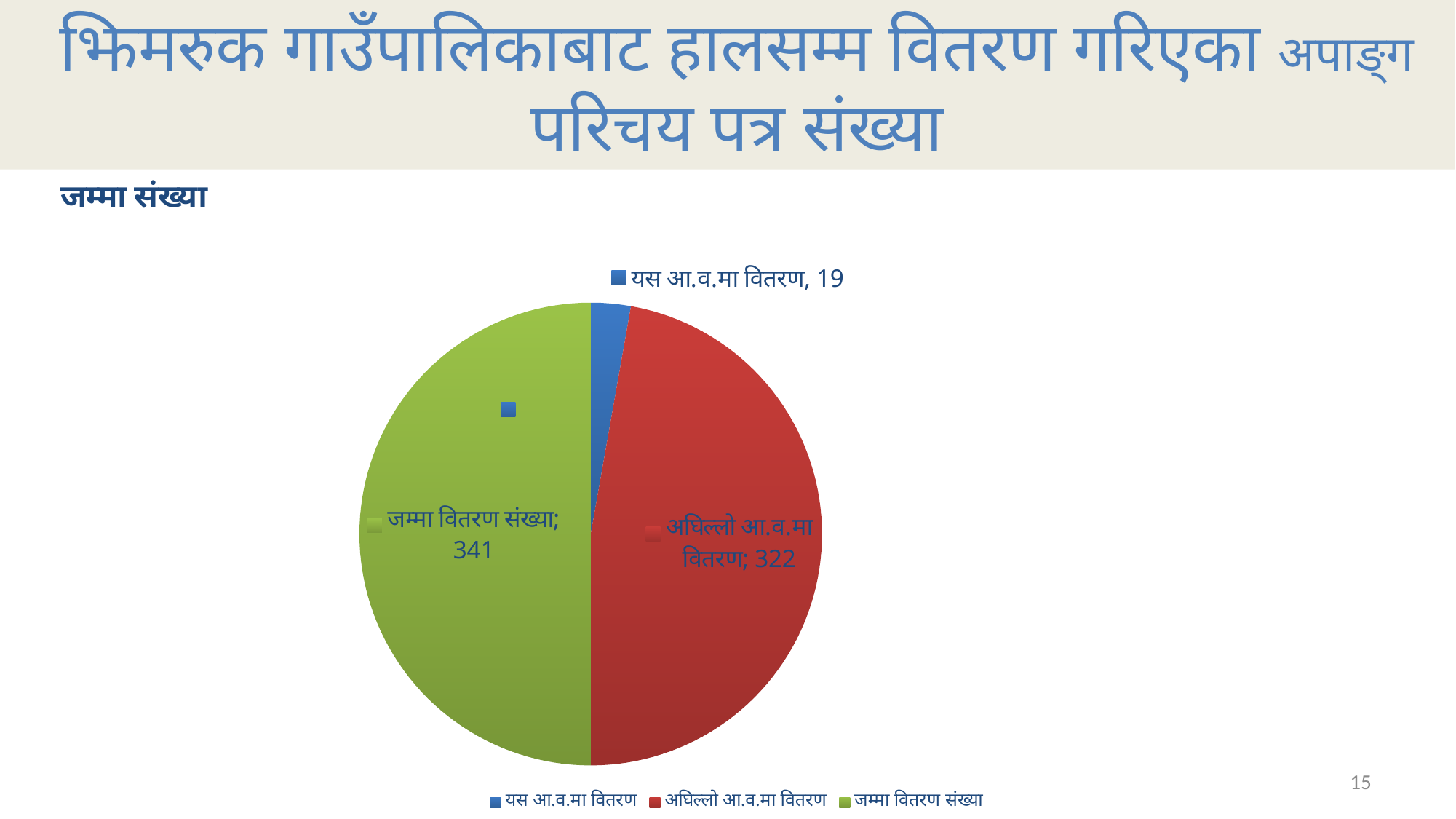
What is the difference between जम्मा वितरण संख्या and अघिल्लो आ.व.मा वितरण? 19 What kind of chart is shown on the slide? pie chart Which slice has the smallest value? यस आ.व.मा वितरण What share of the pie does जम्मा वितरण संख्या represent? 50% What is the title of the chart? जम्मा संख्या What is the value for यस आ.व.मा वितरण? 19 What is the difference between अघिल्लो आ.व.मा वितरण and यस आ.व.मा वितरण? 303 Which slice has the largest value? जम्मा वितरण संख्या What is the value for जम्मा वितरण संख्या? 341 How many slices does the pie chart have? 3 What is the value for अघिल्लो आ.व.मा वितरण? 322 Which is larger, अघिल्लो आ.व.मा वितरण or यस आ.व.मा वितरण? अघिल्लो आ.व.मा वितरण